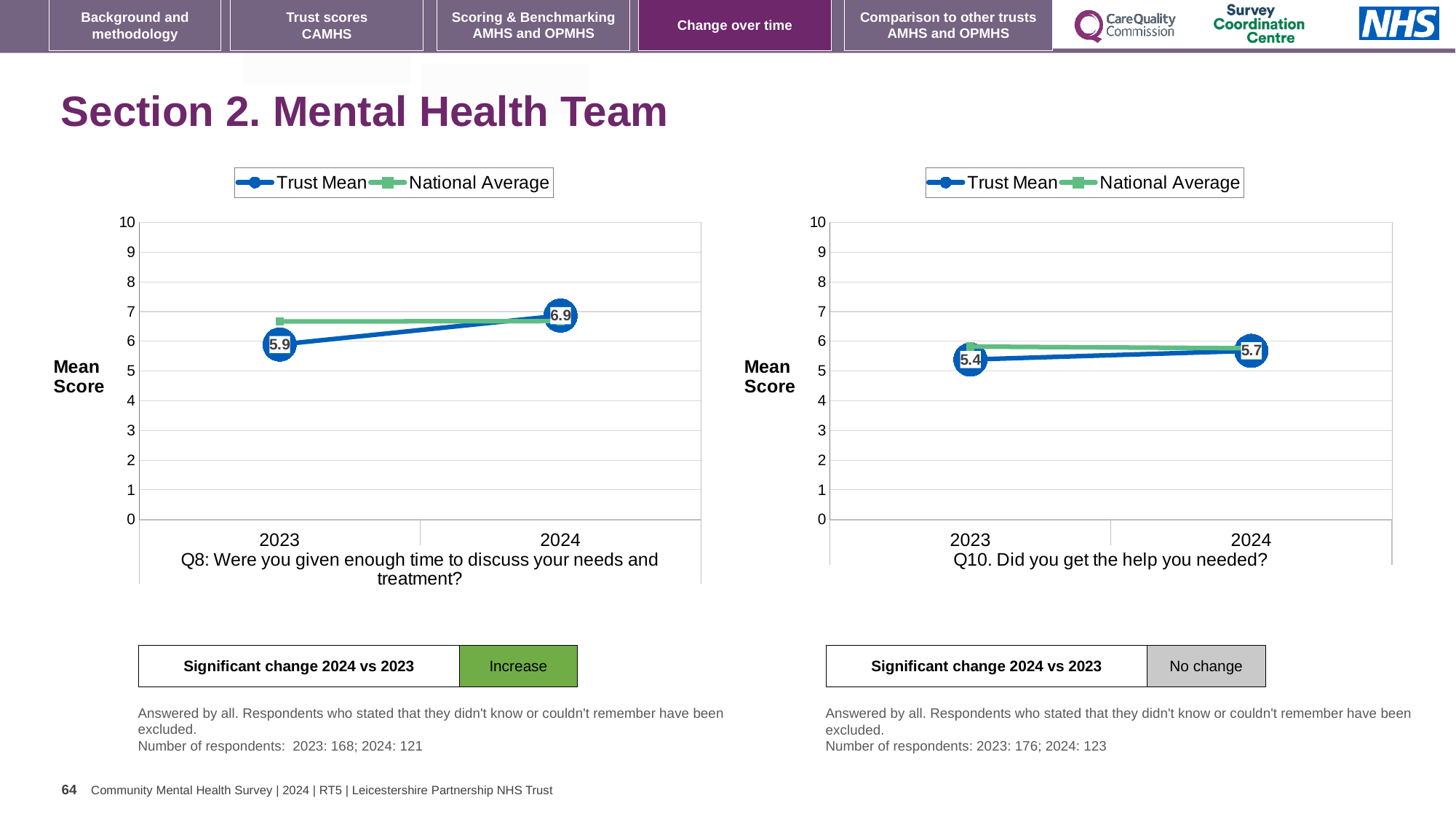
In the left chart (Q8), what is the Trust Mean score for 2023? 5.9 In the right chart (Q10), what is the Trust Mean score for 2023? 5.4 In the right chart (Q10), what is the difference between the Trust Mean for 2024 and 2023? 0.3 What does the 'Significant change 2024 vs 2023' box below the left chart (Q8) say? Increase In the left chart (Q8), what is the Trust Mean score for 2024? 6.9 In the left chart (Q8), does the Trust Mean rise or fall from 2023 to 2024? rise In the left chart (Q8), is the National Average for 2023 greater or less than 6? greater In the right chart (Q10), is the Trust Mean for 2023 greater or less than 6? less In the right chart (Q10), what is the Trust Mean score for 2024? 5.7 What type of chart is used on the left of the slide (Q8)? line chart How many series does the legend of the right chart (Q10) list? 2 In the left chart (Q8), by how much did the Trust Mean change from 2023 to 2024? 1.0